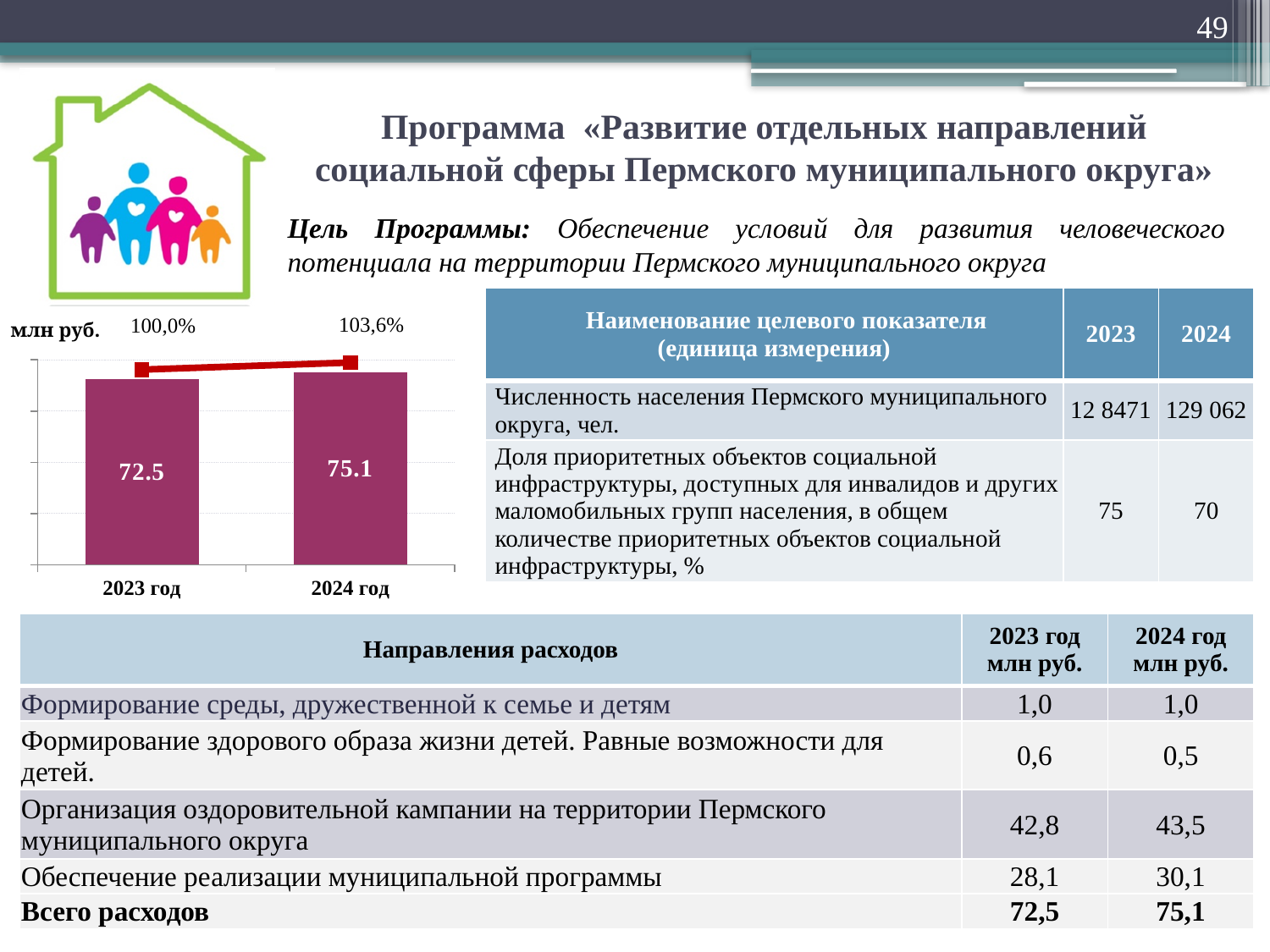
What percentage label is shown above the 2024 год bar? 103,6% Is the bar for 2024 год larger or smaller than the bar for 2023 год? larger By how much does the 2024 год value exceed the 2023 год value in the bar chart? 2.6 Which year has the higher bar in the chart? 2024 год What is the value for 2024 год in the bar chart? 75.1 Do the bar values rise or fall from 2023 год to 2024 год? rise Which year has the lower bar in the chart? 2023 год What is the value for 2023 год in the bar chart? 72.5 What unit is indicated for the values in the bar chart? млн руб. What percentage label is shown above the 2023 год bar? 100,0% What type of chart is shown on the slide? combination bar and line chart How many bars are shown in the chart? 2